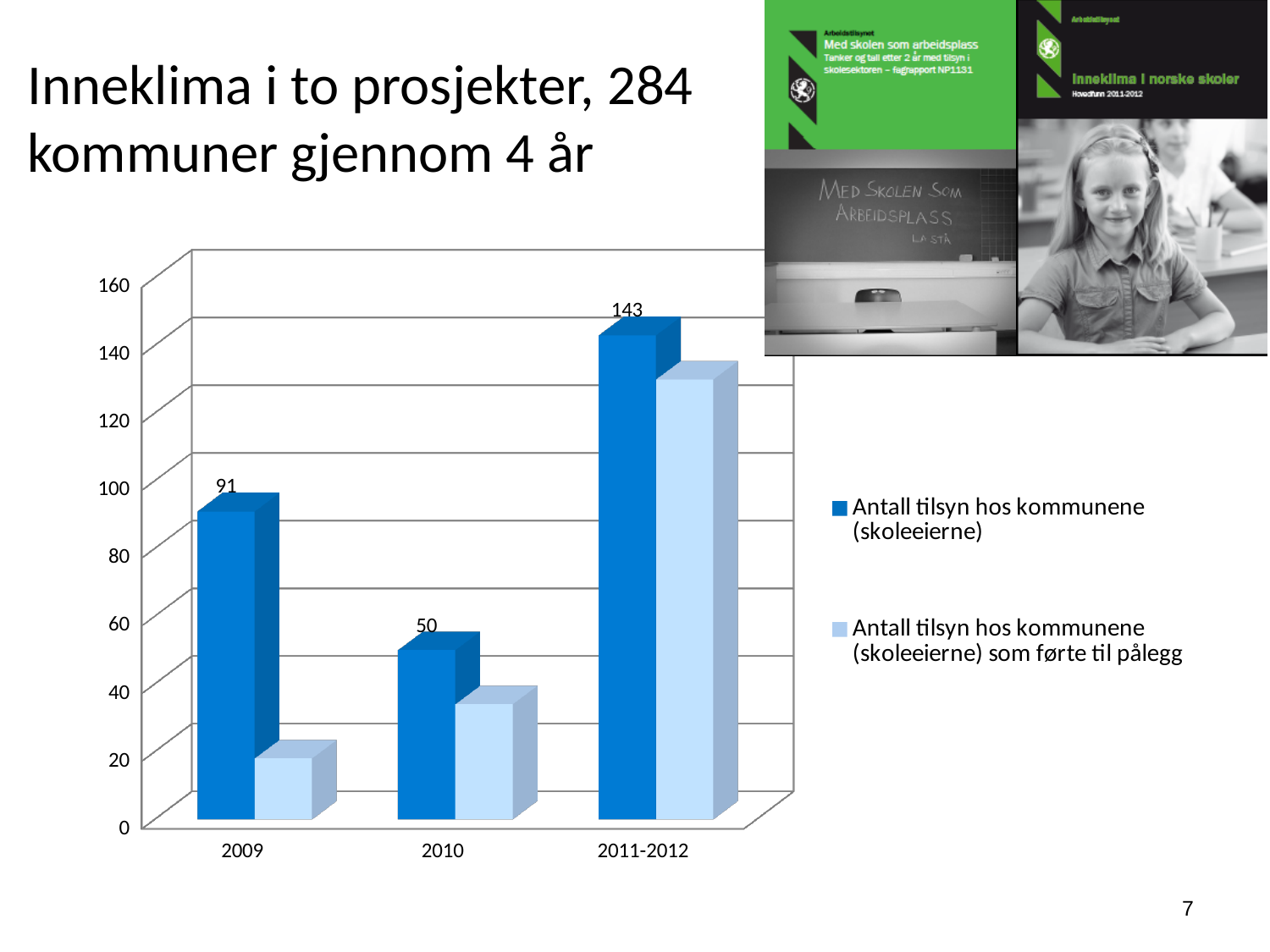
Which category has the highest value in the series "Antall tilsyn hos kommunene (skoleeierne)"? 2011-2012 Is the value for 2009 in the series "Antall tilsyn hos kommunene (skoleeierne) som førte til pålegg" greater or less than 40? less What is the value for 2009 in the series "Antall tilsyn hos kommunene (skoleeierne)"? 91 What is the difference between the 2011-2012 and 2009 values in the series "Antall tilsyn hos kommunene (skoleeierne)"? 52 What kind of chart is shown on the slide? bar chart Which category has the lowest value in the series "Antall tilsyn hos kommunene (skoleeierne)"? 2010 In the series "Antall tilsyn hos kommunene (skoleeierne)", which is larger: the value for 2009 or the value for 2010? 2009 How many categories are shown on the x axis of the chart? 3 What is the value for 2010 in the series "Antall tilsyn hos kommunene (skoleeierne)"? 50 How many series does the chart legend list? 2 Is the value for 2011-2012 in the series "Antall tilsyn hos kommunene (skoleeierne) som førte til pålegg" greater or less than 100? greater What is the value for 2011-2012 in the series "Antall tilsyn hos kommunene (skoleeierne)"? 143